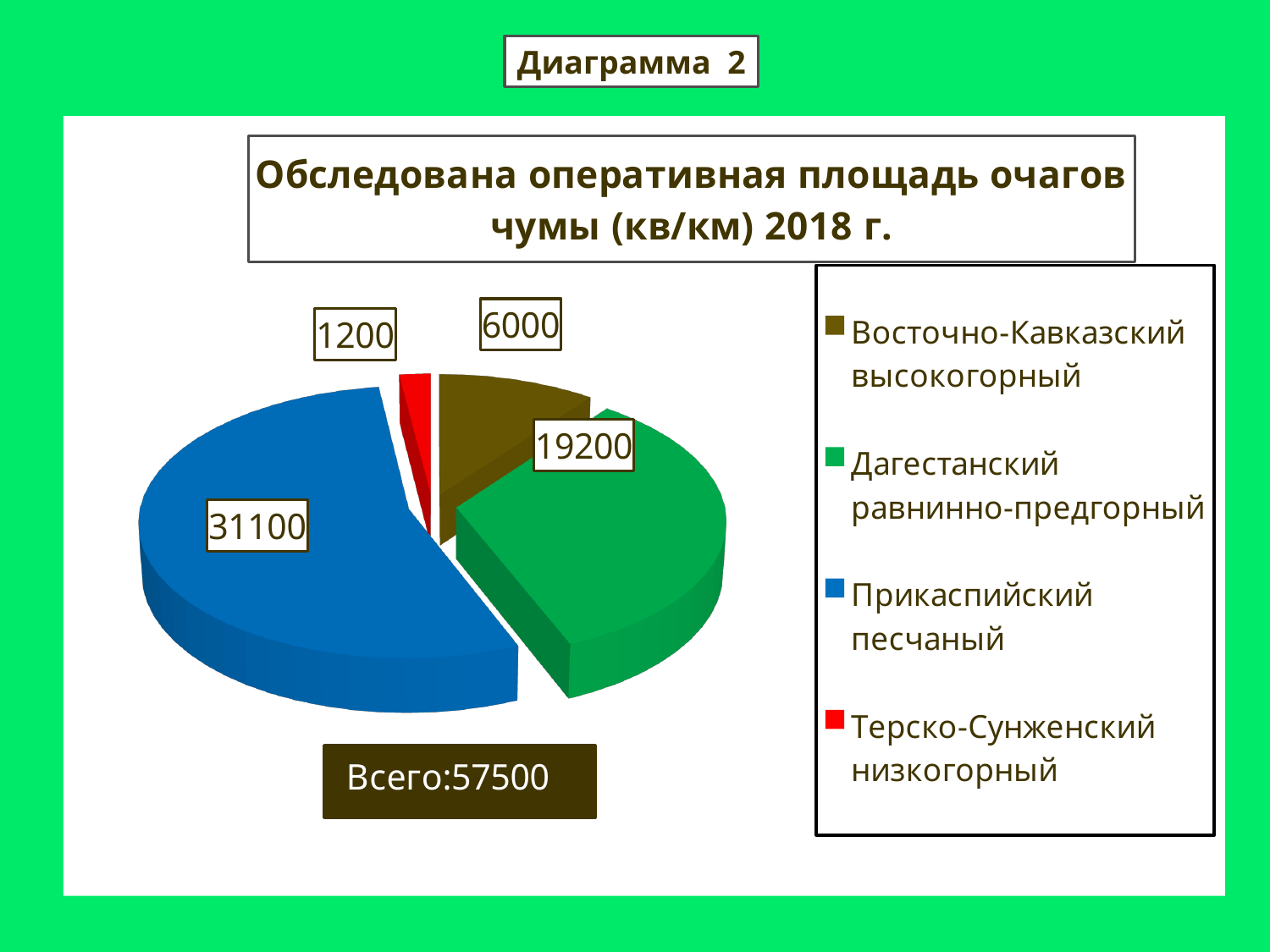
What value is shown for Восточно-Кавказский высокогорный? 6000 How many categories does the pie chart show? 4 What kind of chart is shown on the slide? Pie chart Which category has the smallest slice of the pie? Терско-Сунженский низкогорный What is the difference between the values for Прикаспийский песчаный and Дагестанский равнинно-предгорный? 11900 Which is larger, the value for Восточно-Кавказский высокогорный or for Терско-Сунженский низкогорный? Восточно-Кавказский высокогорный What total is stated below the pie chart? Всего:57500 What value is shown for Терско-Сунженский низкогорный? 1200 What value is shown for Дагестанский равнинно-предгорный? 19200 What value is shown for Прикаспийский песчаный? 31100 What colour is the slice for Дагестанский равнинно-предгорный? Green Which category has the largest slice of the pie? Прикаспийский песчаный